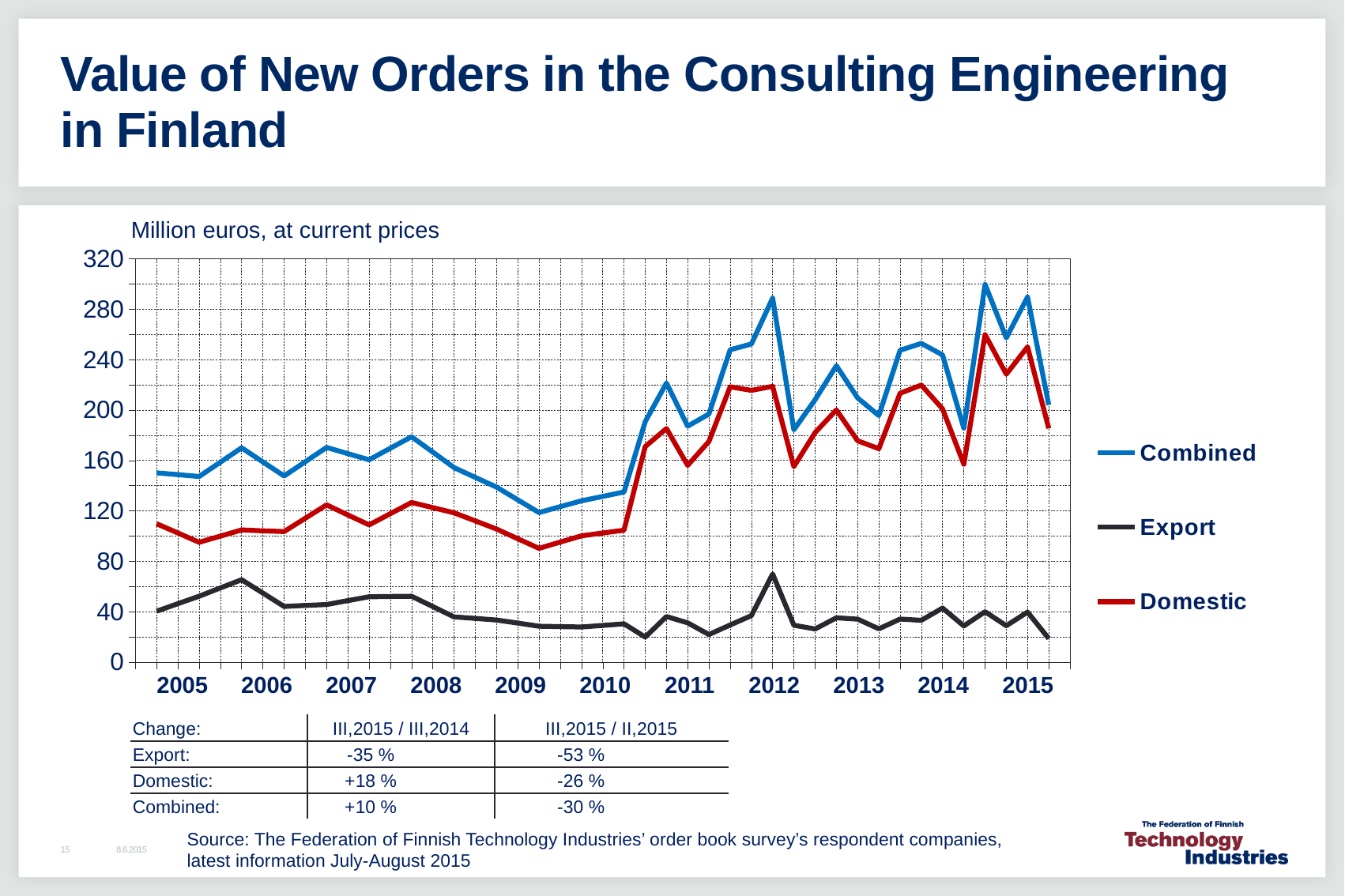
Which series has the lowest values throughout the chart? Export Is the lowest value of the Domestic series around 2009 greater or less than 80? greater In 2012, which is larger, the Domestic value or the Export value? Domestic What unit is stated above the chart? Million euros, at current prices Is the peak value of the Export series in 2012 greater or less than 80? less How many years are labelled on the x axis? 11 Does the Combined series rise or fall between 2008 and 2009? fall What kind of chart is shown on the slide? line chart How many series does the legend list? 3 Is the peak value of the Combined series in 2014 greater or less than 280? greater Which series has the highest values throughout the chart? Combined